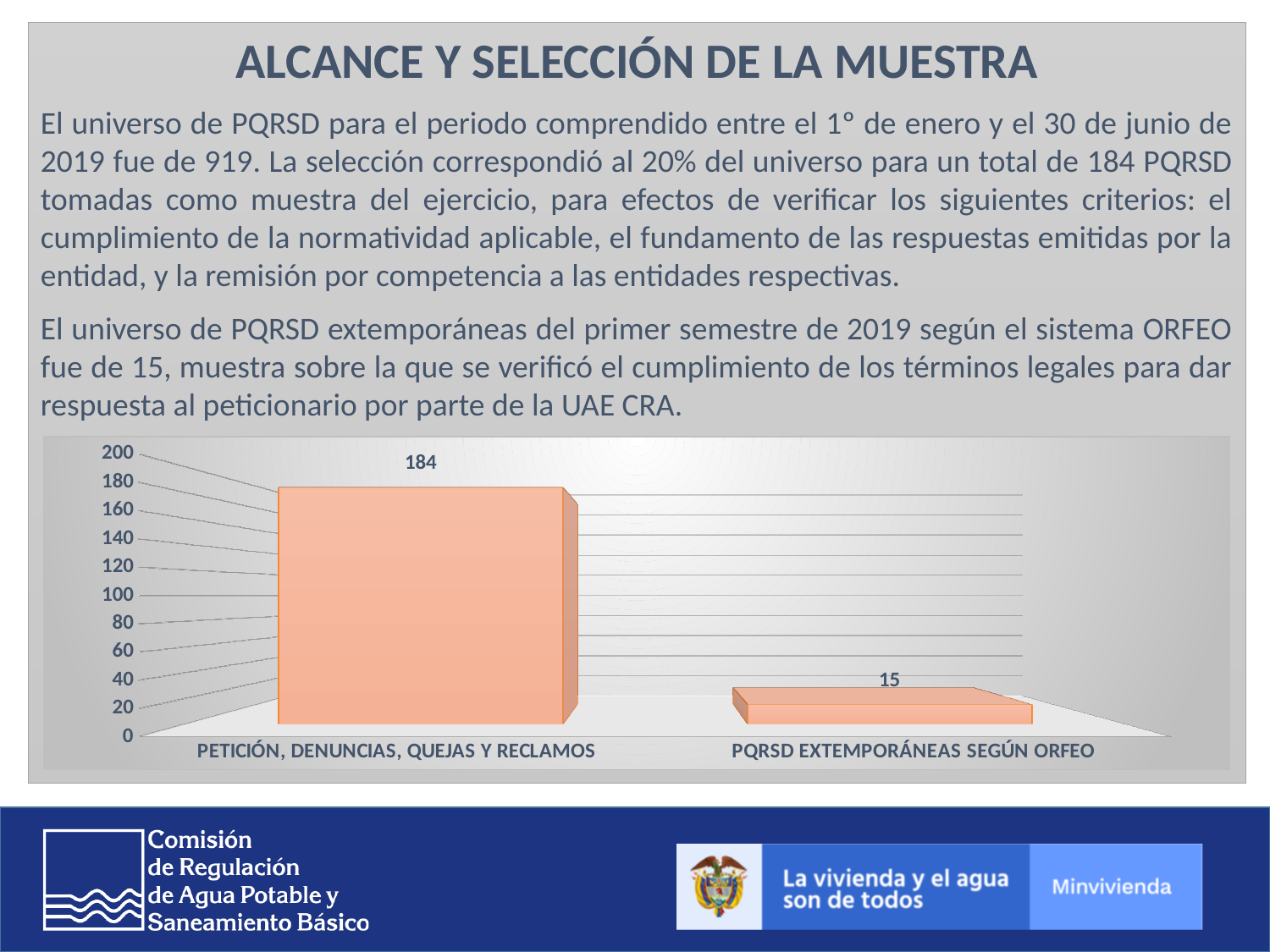
Is the value for PETICIÓN, DENUNCIAS, QUEJAS Y RECLAMOS greater or less than 160? greater Is the value for PQRSD EXTEMPORÁNEAS SEGÚN ORFEO greater or less than 40? less How many categories are shown in the chart? 2 What is the value for PETICIÓN, DENUNCIAS, QUEJAS Y RECLAMOS? 184 Which is larger: the value for PETICIÓN, DENUNCIAS, QUEJAS Y RECLAMOS or the value for PQRSD EXTEMPORÁNEAS SEGÚN ORFEO? PETICIÓN, DENUNCIAS, QUEJAS Y RECLAMOS Which category has the lowest value? PQRSD EXTEMPORÁNEAS SEGÚN ORFEO What is the value for PQRSD EXTEMPORÁNEAS SEGÚN ORFEO? 15 What is the difference between the values for PETICIÓN, DENUNCIAS, QUEJAS Y RECLAMOS and PQRSD EXTEMPORÁNEAS SEGÚN ORFEO? 169 What colour are the bars in the chart? orange Which category has the highest value? PETICIÓN, DENUNCIAS, QUEJAS Y RECLAMOS What kind of chart is shown on the slide? bar chart What is the maximum value shown on the vertical axis of the chart? 200